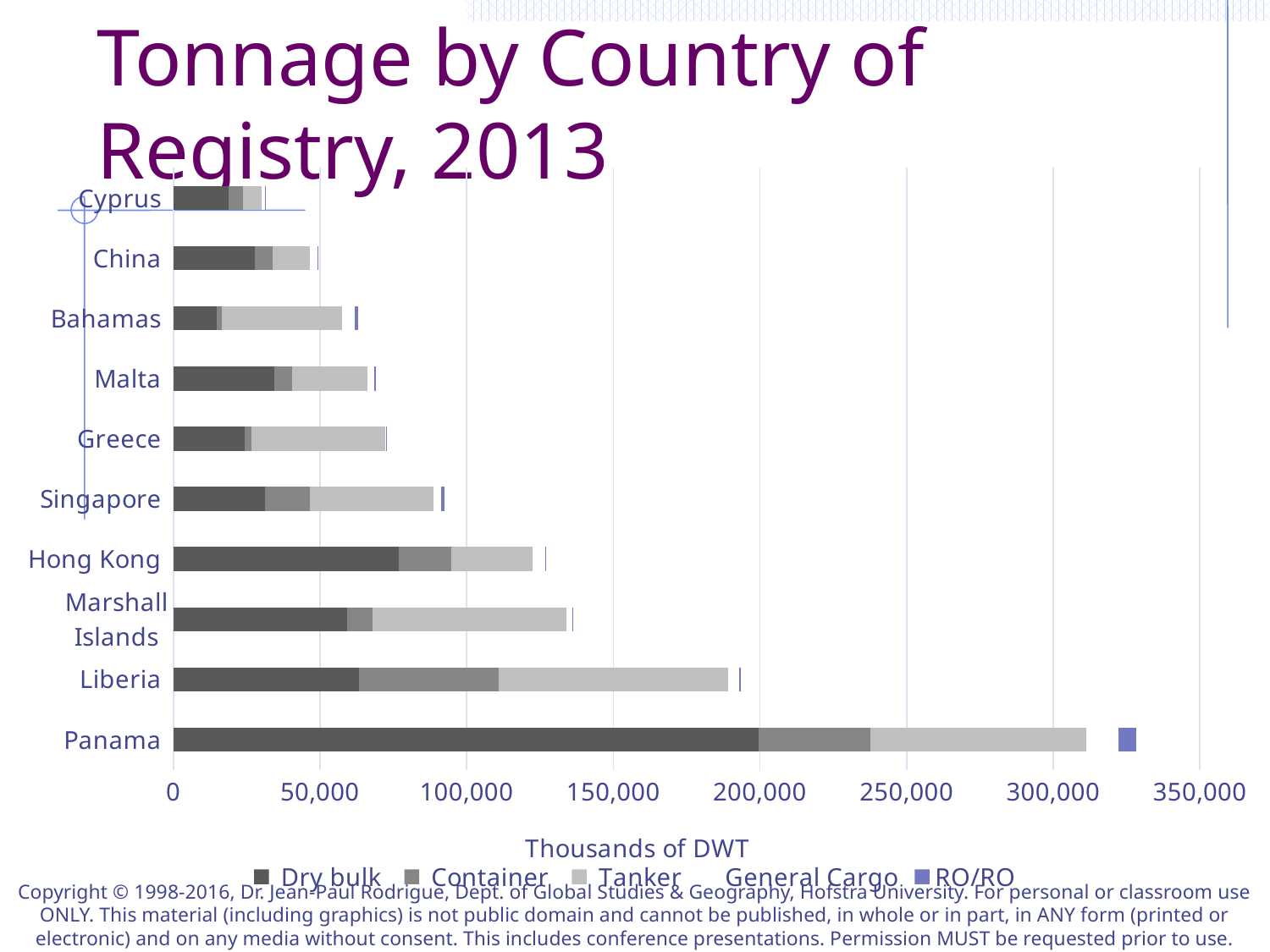
Is the total tonnage for Panama greater or less than 300,000? greater What is the title of the x axis? Thousands of DWT What kind of chart is shown on the slide? Stacked bar chart How many series does the legend list? 5 Which country has the lowest total tonnage? Cyprus Which has a larger total tonnage, Hong Kong or Singapore? Hong Kong Which has a larger total tonnage, Liberia or Marshall Islands? Liberia Is the total tonnage for Liberia greater or less than 200,000? less How many countries are shown on the chart? 10 Is the total tonnage for Hong Kong greater or less than 100,000? greater What is the first series listed in the legend? Dry bulk Which country has the highest total tonnage? Panama